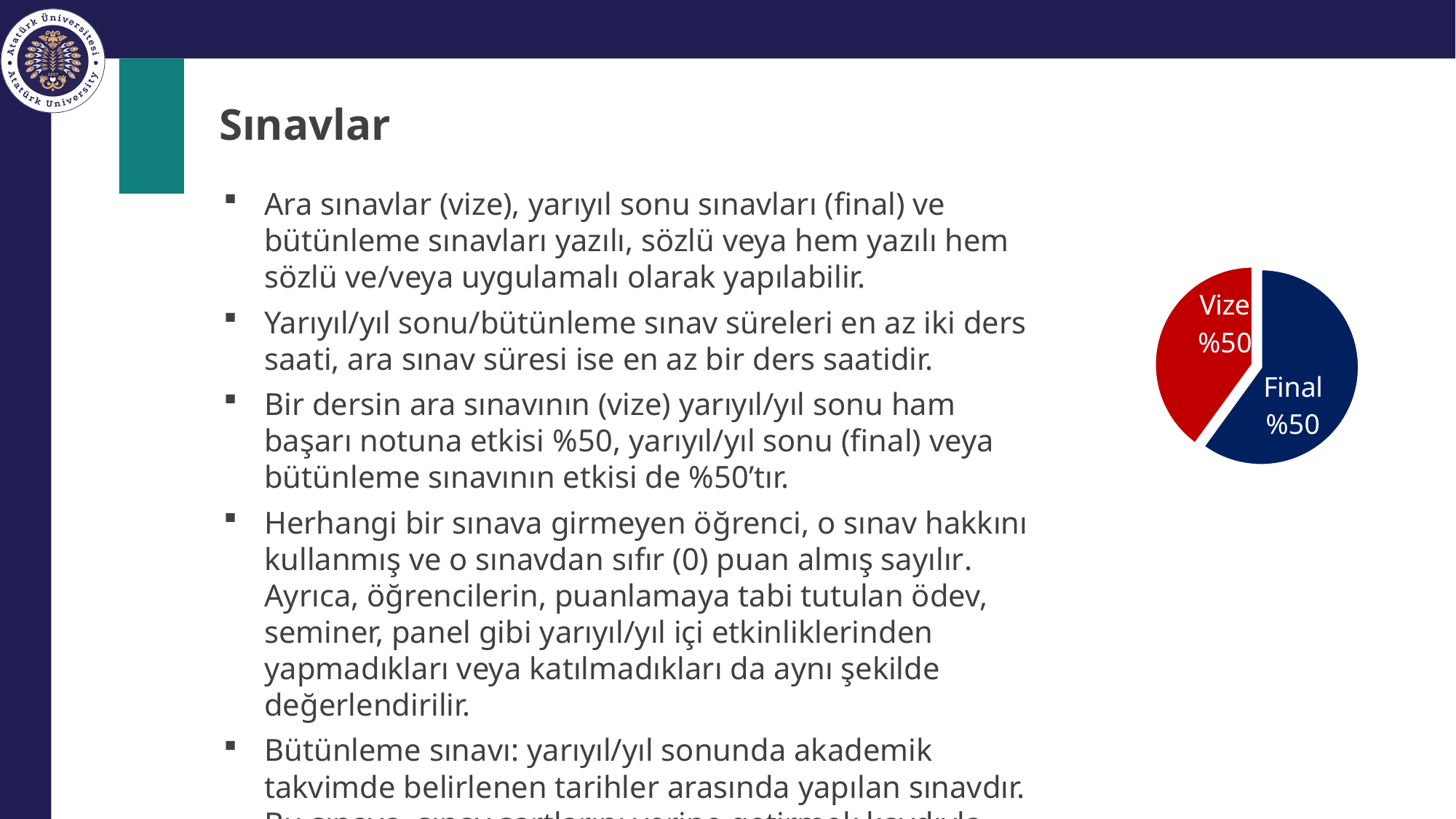
What colour is the Vize slice of the pie chart? red What colour is the Final slice of the pie chart? dark blue What kind of chart is shown on the slide? pie chart What are the labels of the two slices in the pie chart? Vize and Final What value is shown for the Vize slice of the pie chart? %50 How many slices does the pie chart have? 2 What value is shown for the Final slice of the pie chart? %50